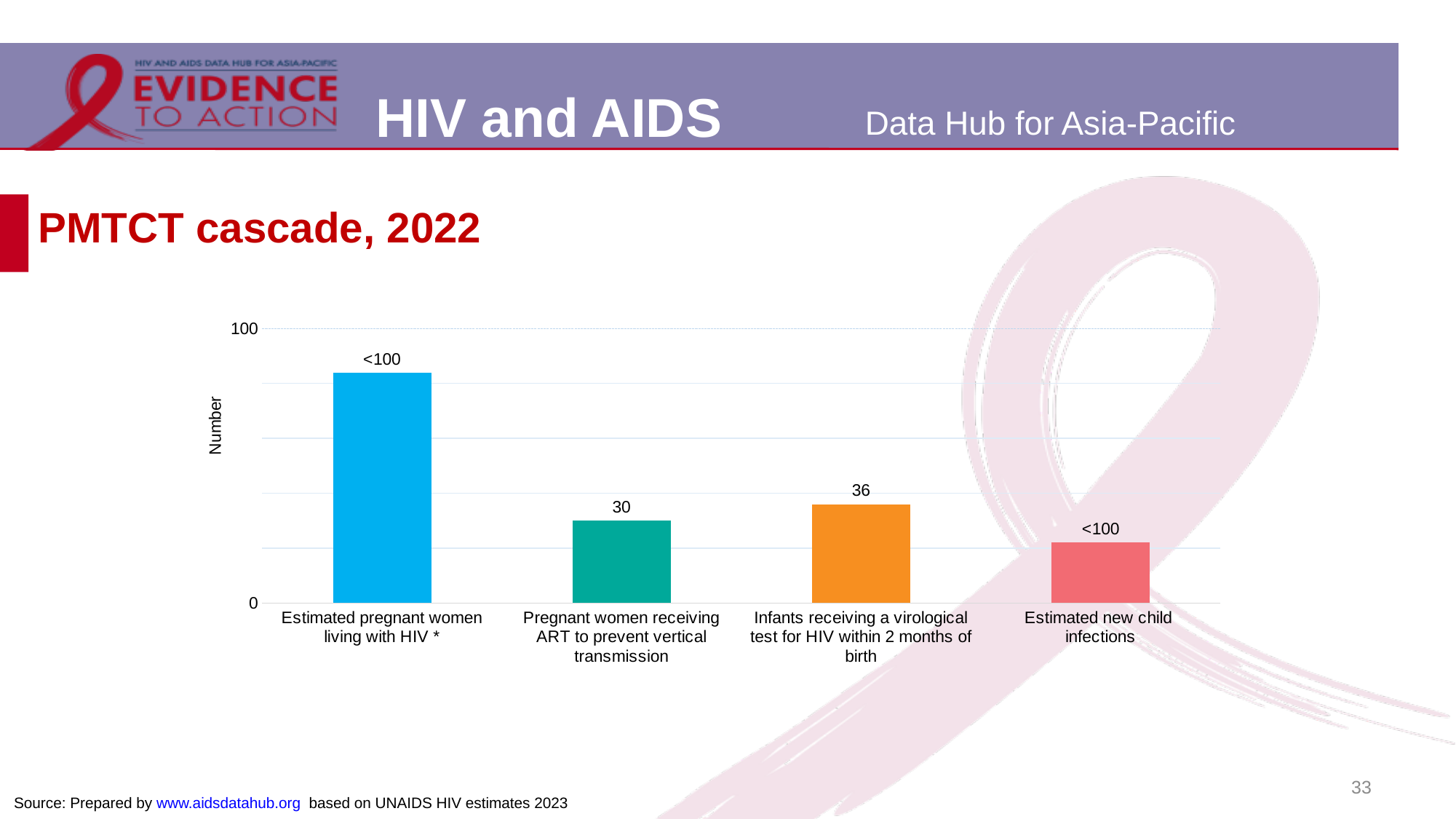
What value is shown for Infants receiving a virological test for HIV within 2 months of birth? 36 What is the difference between the value for Infants receiving a virological test for HIV within 2 months of birth and the value for Pregnant women receiving ART to prevent vertical transmission? 6 What value is shown for Pregnant women receiving ART to prevent vertical transmission? 30 Which is larger: the value for Infants receiving a virological test for HIV within 2 months of birth or the value for Pregnant women receiving ART to prevent vertical transmission? Infants receiving a virological test for HIV within 2 months of birth Which category has the tallest bar in the chart? Estimated pregnant women living with HIV Is the bar for Estimated new child infections greater or less than 50? less How many categories are shown in the chart? 4 What is the data label on the bar for Estimated pregnant women living with HIV? <100 What type of chart is shown on the slide? Bar chart What is the label on the vertical axis of the chart? Number Is the bar for Estimated pregnant women living with HIV greater or less than 50? greater What is the data label on the bar for Estimated new child infections? <100